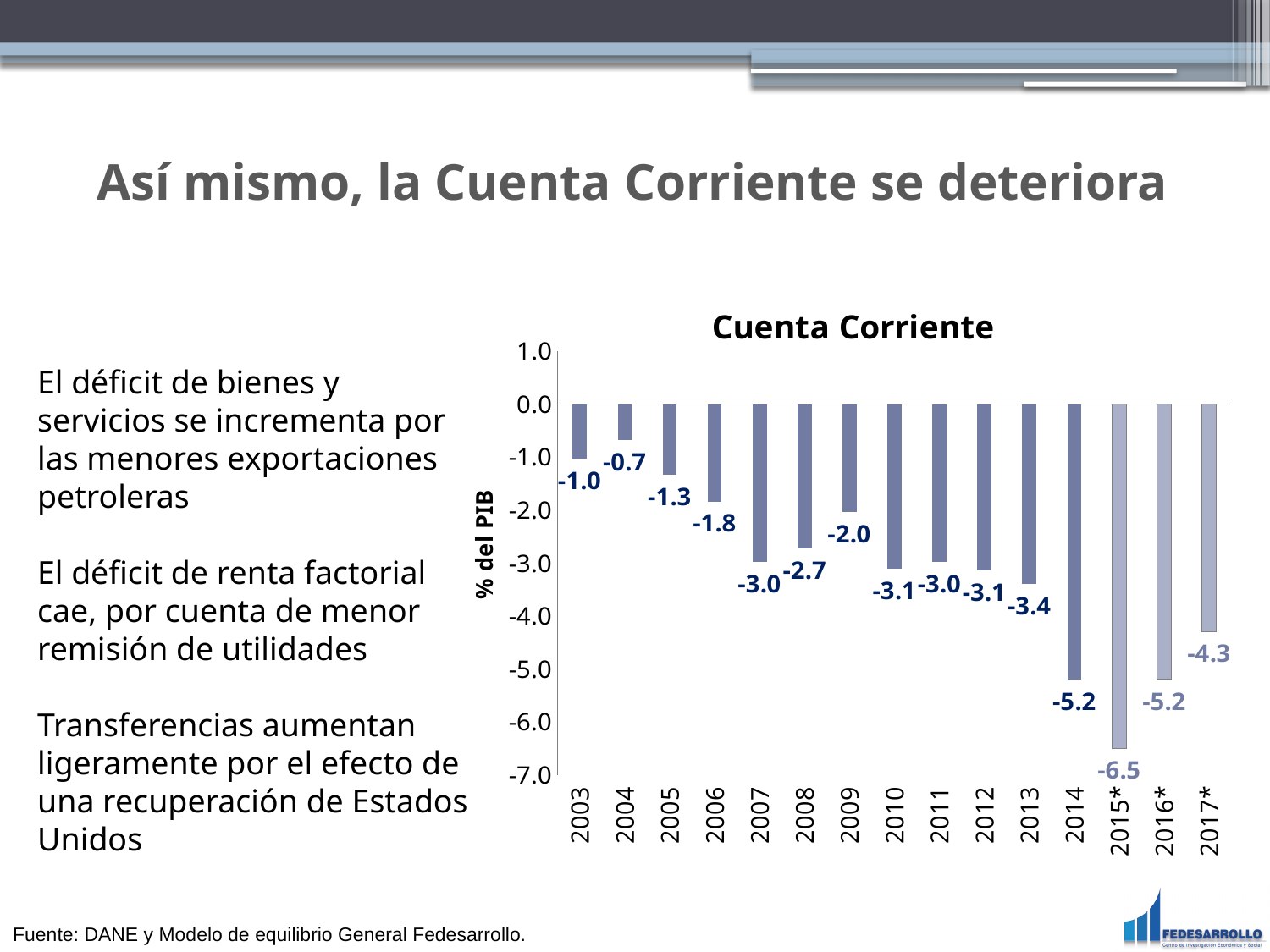
What is the value for 2015* in the Cuenta Corriente chart? -6.5 What kind of chart is the Cuenta Corriente chart? Bar chart What is the title of the chart on the slide? Cuenta Corriente What is the value for 2017* in the Cuenta Corriente chart? -4.3 Which year has the highest (least negative) value in the Cuenta Corriente chart? 2004 Which year has the lowest (most negative) value in the Cuenta Corriente chart? 2015* Do the values in the Cuenta Corriente chart generally rise or fall from 2009 to 2015*? Fall What is the difference between the values for 2014 and 2015* in the Cuenta Corriente chart? 1.3 Which is larger in the Cuenta Corriente chart, the value for 2006 or the value for 2013? 2006 How many years are shown on the x axis of the Cuenta Corriente chart? 15 What is the value for 2008 in the Cuenta Corriente chart? -2.7 What is the label of the vertical axis in the Cuenta Corriente chart? % del PIB